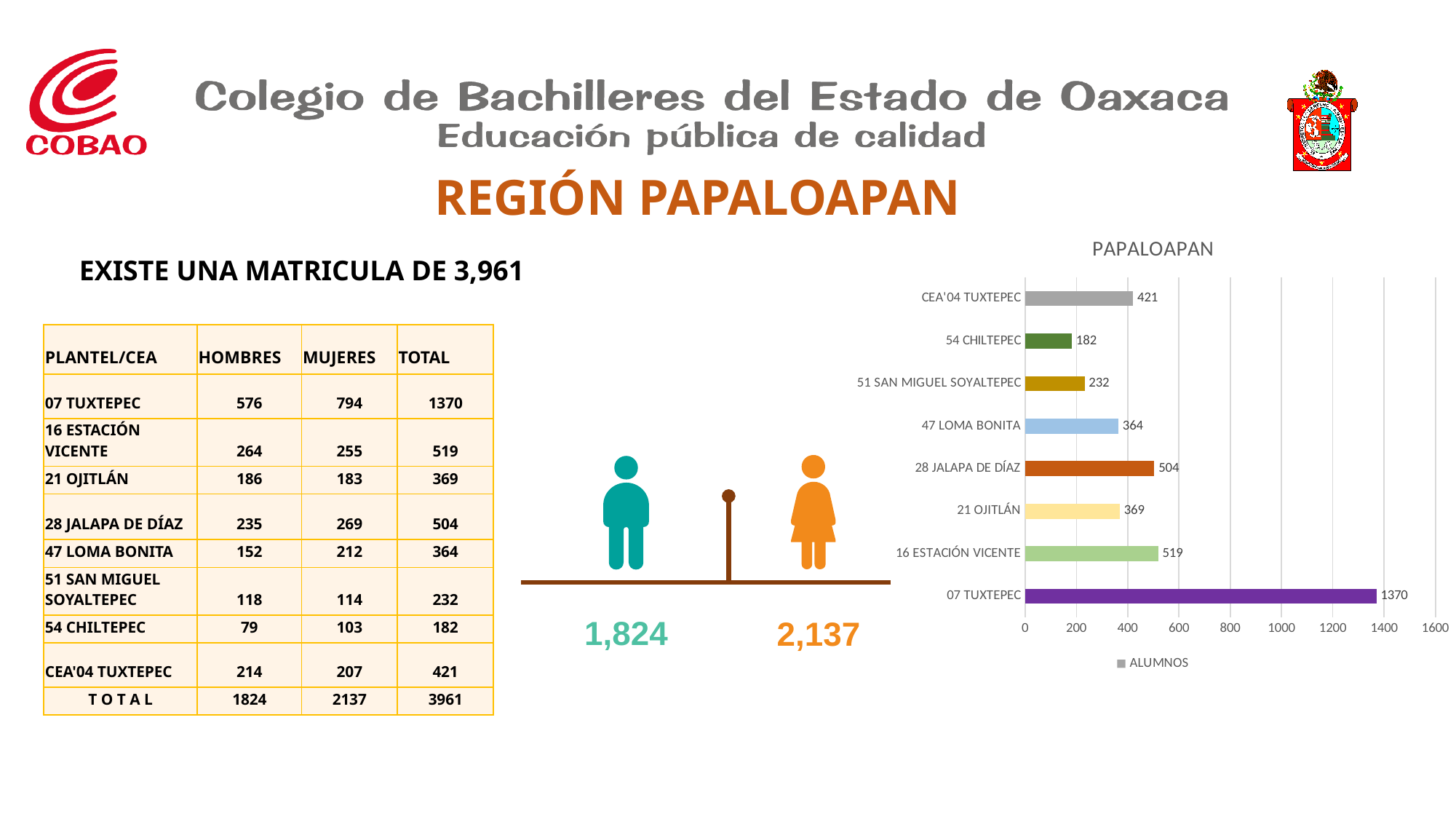
How many categories does the PAPALOAPAN chart show? 8 What is the value for 47 LOMA BONITA in the PAPALOAPAN chart? 364 What is the title of the bar chart? PAPALOAPAN What is the difference between the values for 28 JALAPA DE DÍAZ and 21 OJITLÁN in the PAPALOAPAN chart? 135 What is the legend entry of the PAPALOAPAN chart? ALUMNOS What is the value for 07 TUXTEPEC in the PAPALOAPAN chart? 1370 What type of chart is shown on the slide? bar chart Is the value for 51 SAN MIGUEL SOYALTEPEC in the PAPALOAPAN chart greater or less than 400? less Which category has the highest value in the PAPALOAPAN chart? 07 TUXTEPEC Which category has the lowest value in the PAPALOAPAN chart? 54 CHILTEPEC Which is larger in the PAPALOAPAN chart, CEA'04 TUXTEPEC or 16 ESTACIÓN VICENTE? 16 ESTACIÓN VICENTE How many series does the legend of the PAPALOAPAN chart list? 1